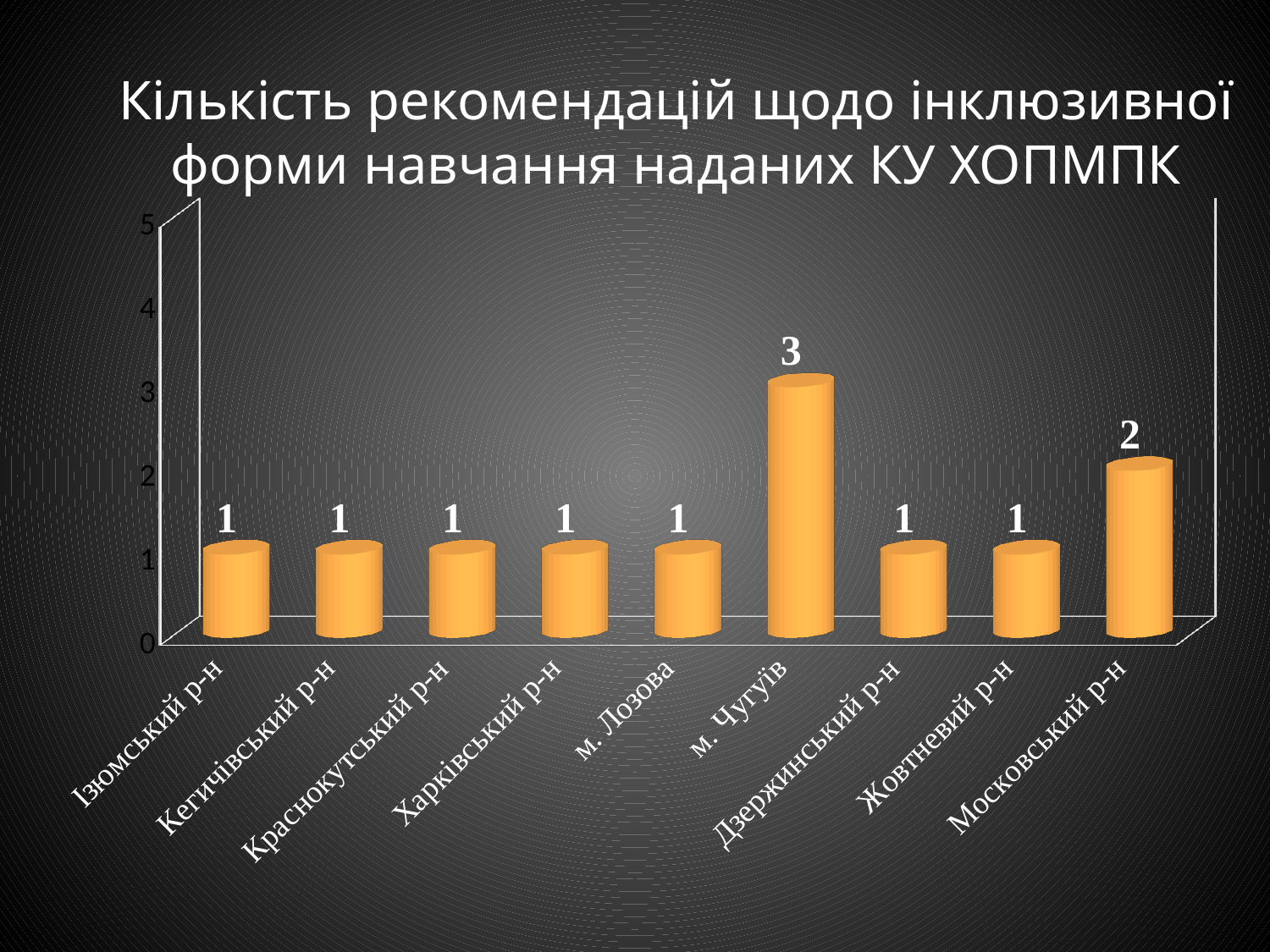
What kind of chart is shown on the slide? bar chart Which category has the highest value? м. Чугуїв How many categories are shown on the x axis? 9 What is the value for м. Чугуїв? 3 What is the value for Московський р-н? 2 What is the value for Ізюмський р-н? 1 What is the title of the chart? Кількість рекомендацій щодо інклюзивної форми навчання наданих КУ ХОПМПК What is the value for м. Лозова? 1 What is the difference between the values for м. Чугуїв and Московський р-н? 1 Which is larger, the value for м. Чугуїв or the value for Дзержинський р-н? м. Чугуїв Is the value for м. Чугуїв greater or less than 2? greater What is the difference between the values for Московський р-н and Жовтневий р-н? 1